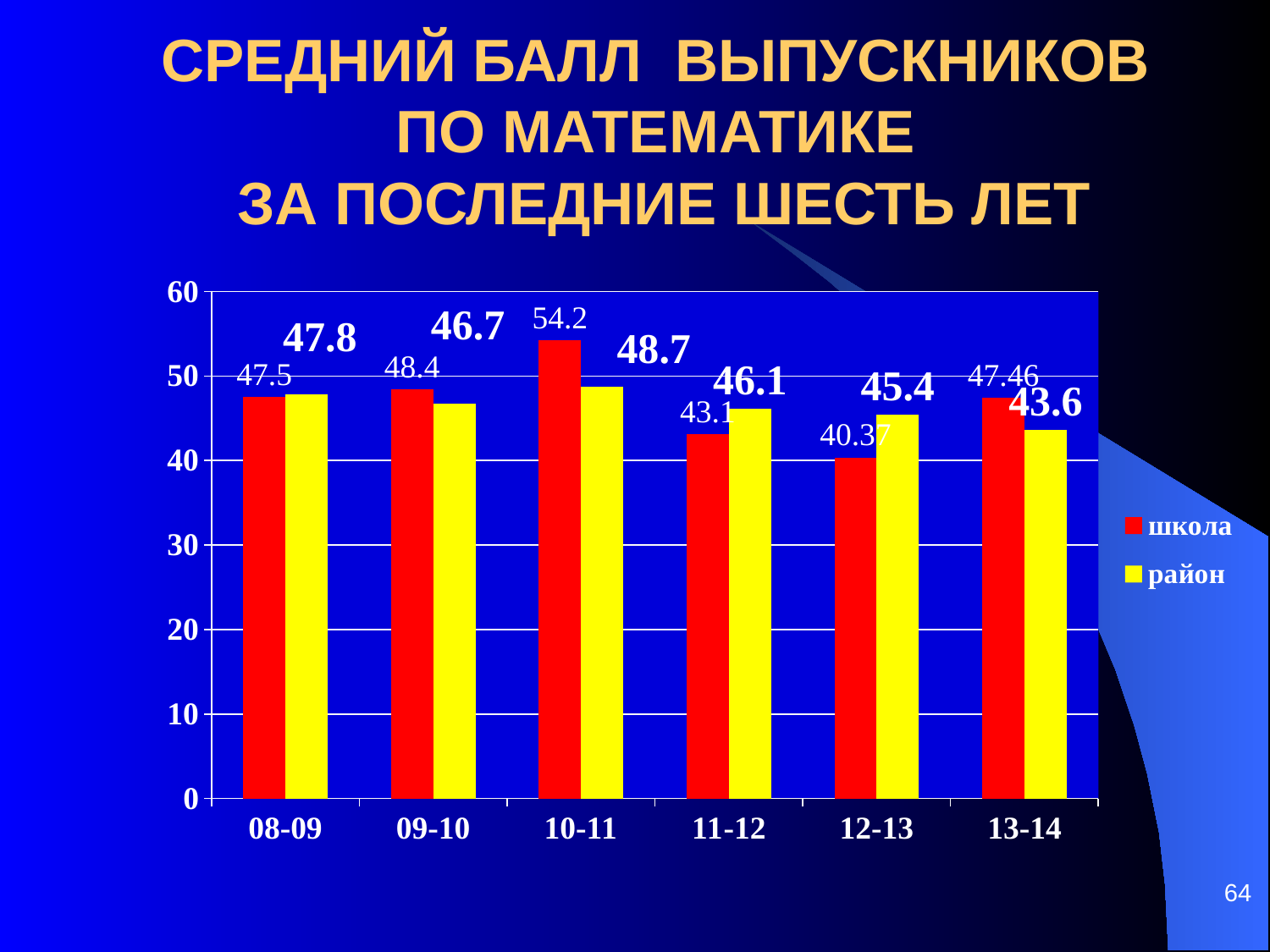
Which is larger in 11-12, школа or район? район In which year is the район value lowest? 13-14 How many series does the legend list? 2 How many years are shown on the x axis? 6 In which year is the школа value highest? 10-11 What is the value for школа in 10-11? 54.2 What is the value for район in 12-13? 45.4 What is the difference between школа and район in 10-11? 5.5 What is the value for район in 13-14? 43.6 What kind of chart is shown on the slide? bar chart In which year is the школа value lowest? 12-13 What is the value for школа in 12-13? 40.37